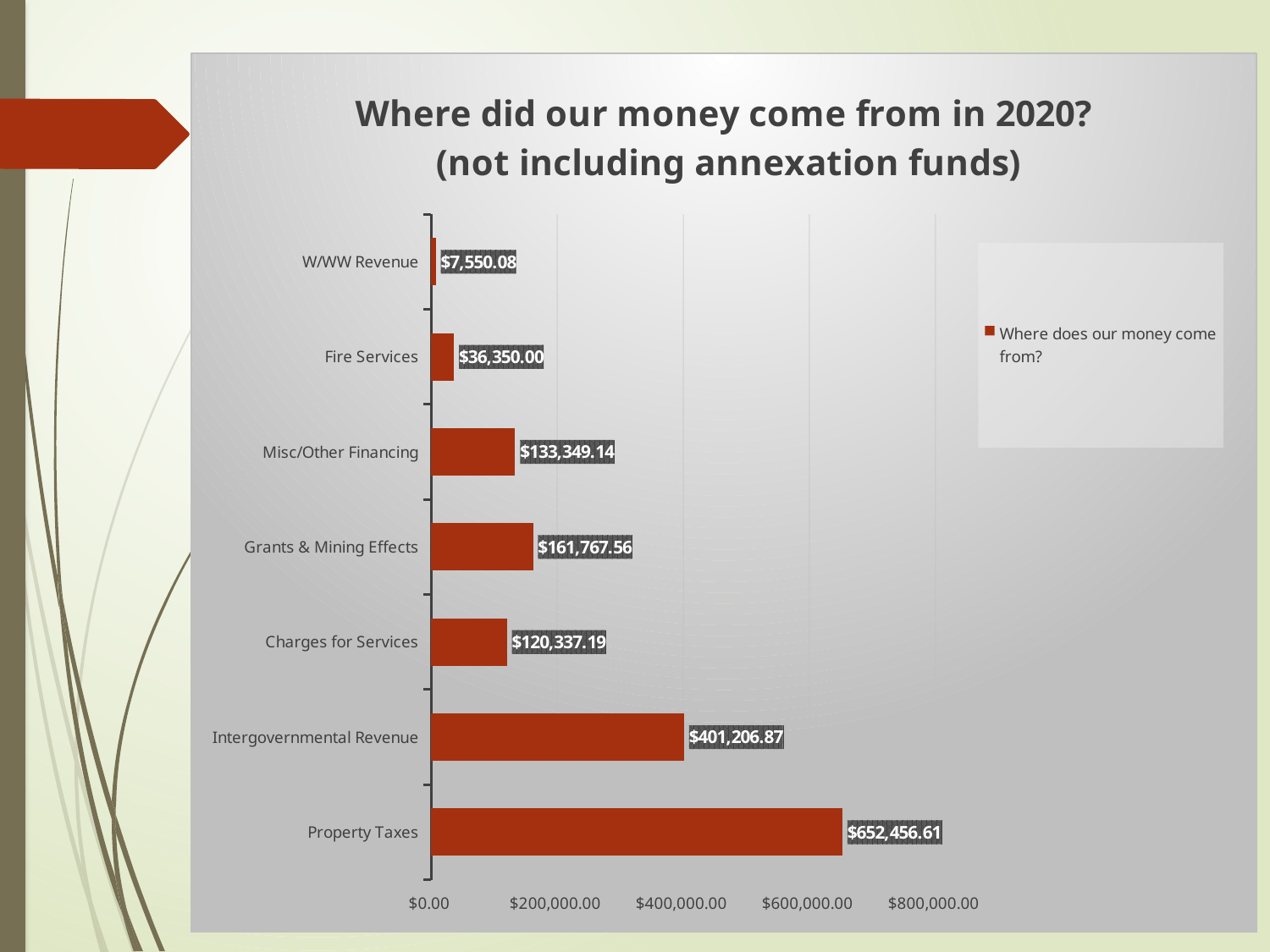
How many categories are shown in the chart? 7 What is the value for W/WW Revenue? $7,550.08 What is the value for Property Taxes? $652,456.61 What is the difference between Property Taxes and Intergovernmental Revenue? $251,249.74 What is the difference between Grants & Mining Effects and Misc/Other Financing? $28,418.42 Which is larger, Charges for Services or Misc/Other Financing? Misc/Other Financing What kind of chart is shown on the slide? Bar chart Which category has the highest value? Property Taxes What is the value for Intergovernmental Revenue? $401,206.87 What is the value for Grants & Mining Effects? $161,767.56 How many series does the legend list? 1 Which category has the lowest value? W/WW Revenue